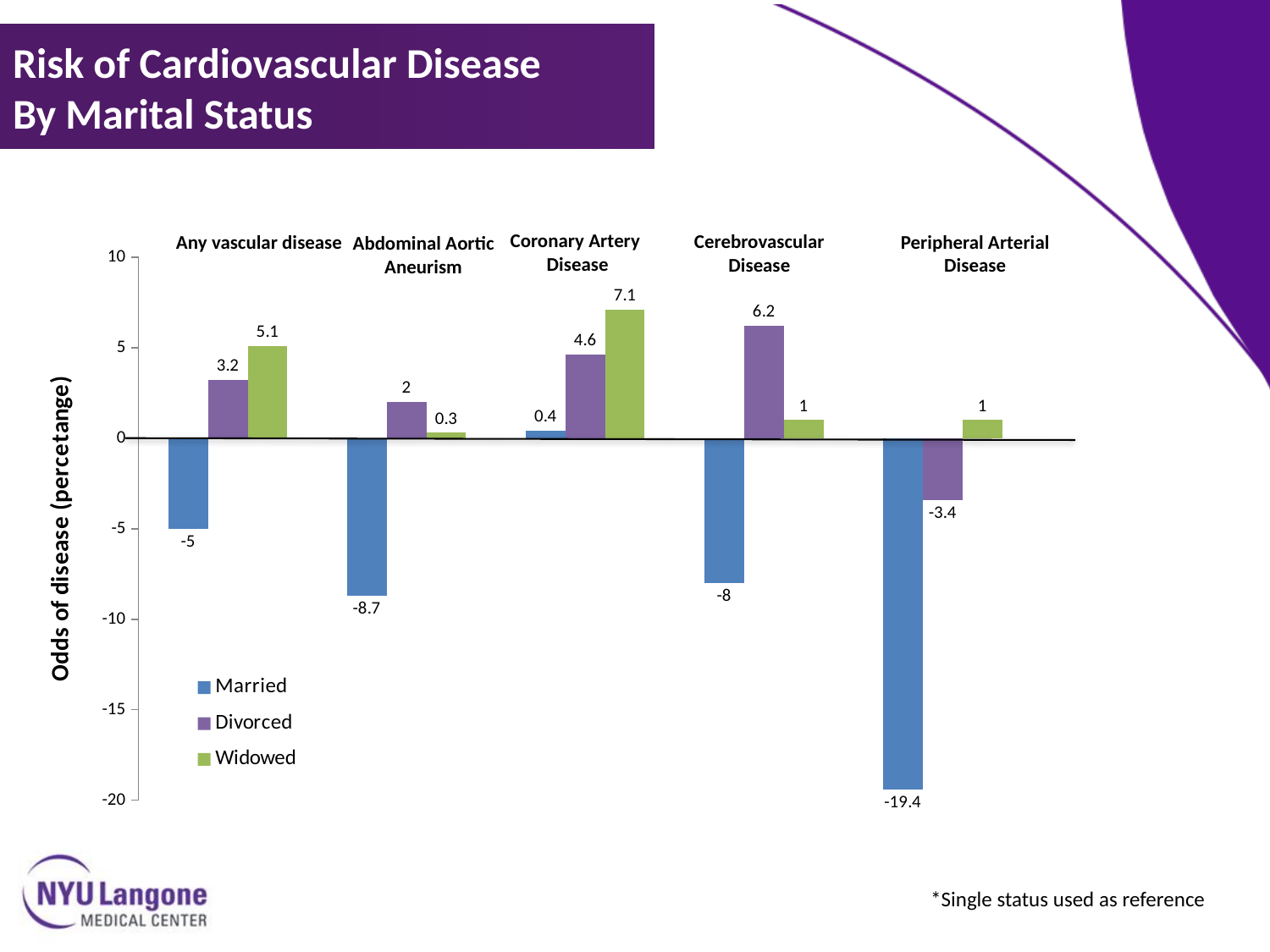
Which category has the highest Widowed value? Coronary Artery Disease What is the value for Widowed in the Coronary Artery Disease category? 7.1 What is the difference between the Widowed and Divorced values for Any vascular disease? 1.9 What is the value for Divorced in the Cerebrovascular Disease category? 6.2 Which is larger for Abdominal Aortic Aneurism: the Divorced value or the Widowed value? Divorced What is the label of the vertical axis? Odds of disease (percetange) How many series does the legend list? 3 Which category has the lowest Married value? Peripheral Arterial Disease What is the value for Married in the Abdominal Aortic Aneurism category? -8.7 What kind of chart is shown on the slide? Bar chart How many disease categories are shown on the x axis? 5 What is the value for Married in the Peripheral Arterial Disease category? -19.4